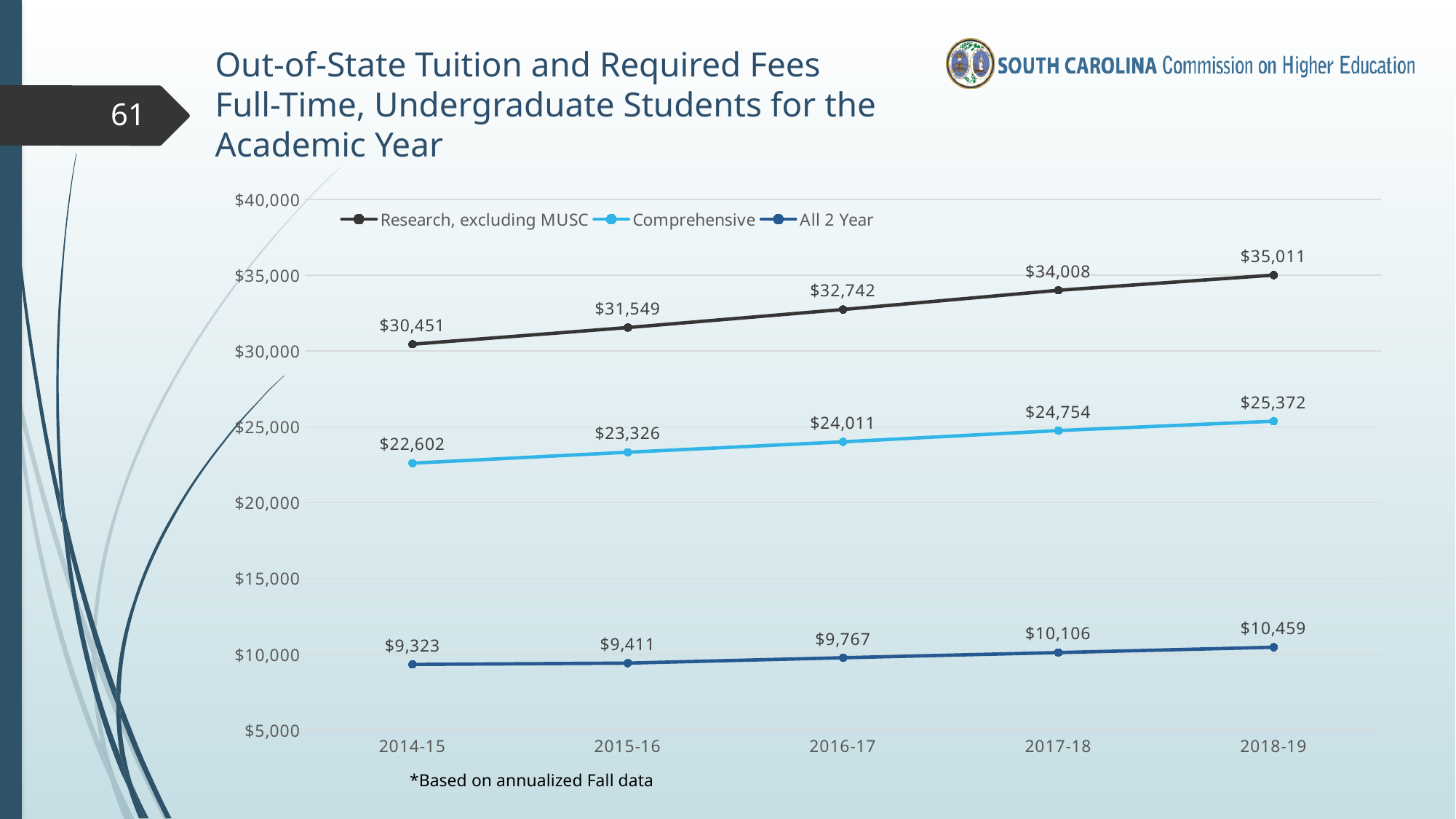
How many academic years are shown on the x axis? 5 Is the Research, excluding MUSC value in 2016-17 greater or less than $30,000? greater In which academic year is the All 2 Year value lowest? 2014-15 What is the value for All 2 Year in 2014-15? $9,323 Do the All 2 Year values rise or fall from 2014-15 to 2018-19? Rise Which is larger in 2017-18: the Comprehensive value or the All 2 Year value? Comprehensive What is the value for Comprehensive in 2016-17? $24,011 What is the difference between the Research, excluding MUSC value in 2018-19 and in 2014-15? $4,560 How many series does the legend list? 3 What kind of chart is shown on the slide? Line chart What is the value for Research, excluding MUSC in 2018-19? $35,011 In which academic year is the Comprehensive value highest? 2018-19